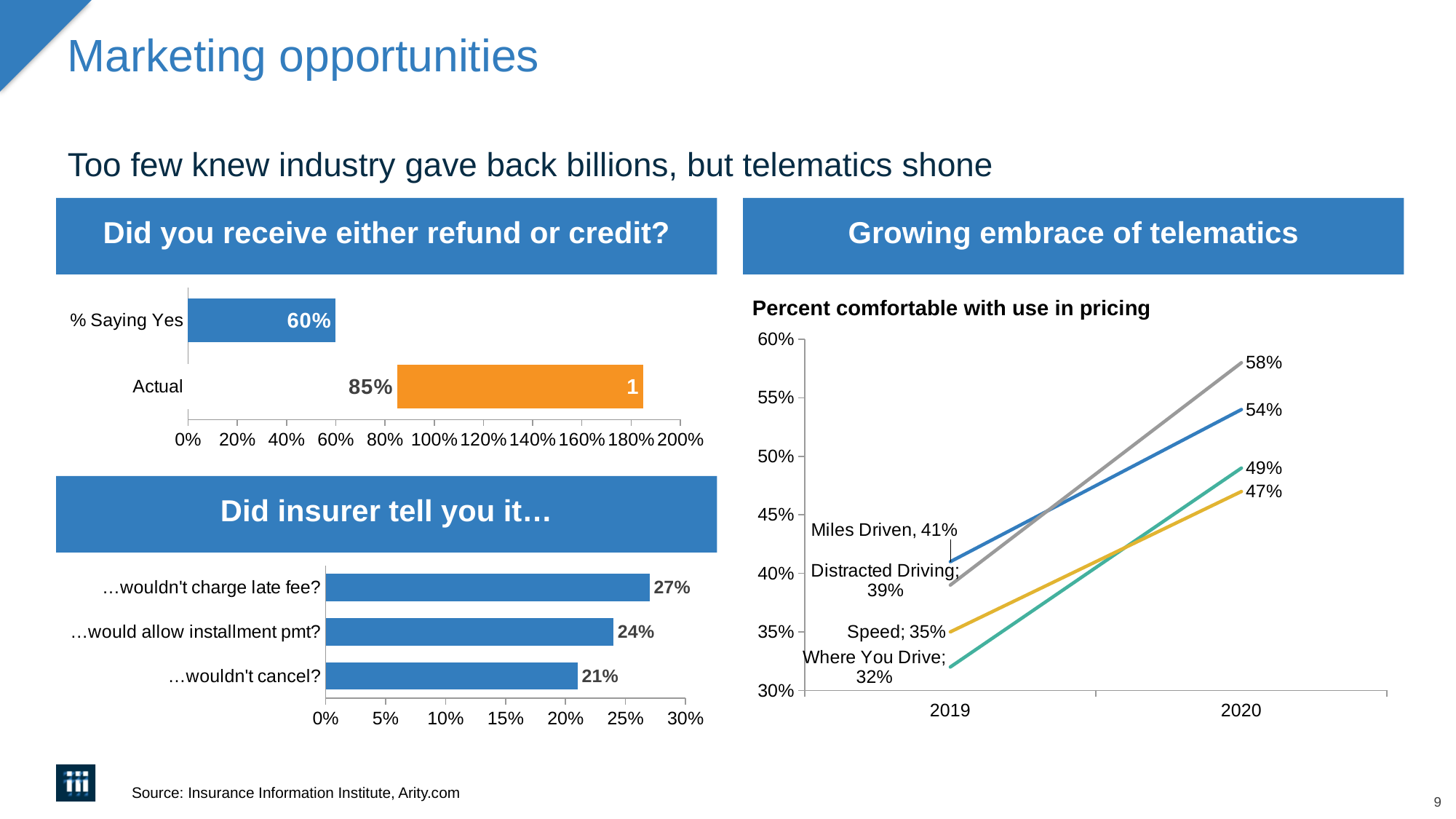
In the 'Growing embrace of telematics' chart, what is the value for Distracted Driving in 2020? 58% What kind of chart is the 'Did you receive either refund or credit?' chart? bar chart In the 'Growing embrace of telematics' chart, by how much did Miles Driven change from 2019 to 2020? 13 percentage points In the 'Did insurer tell you it…' chart, what is the value for '…wouldn't charge late fee?'? 27% In the 'Growing embrace of telematics' chart, do the values rise or fall from 2019 to 2020? rise In the 'Growing embrace of telematics' chart, which series has the highest value in 2020? Distracted Driving In the 'Did you receive either refund or credit?' chart, what is the value for '% Saying Yes'? 60% In the 'Did insurer tell you it…' chart, which category has the lowest value? …wouldn't cancel? In the 'Growing embrace of telematics' chart, which series has the lowest value in 2019? Where You Drive In the 'Did insurer tell you it…' chart, what is the difference between '…wouldn't charge late fee?' and '…would allow installment pmt?'? 3 percentage points How many categories are shown in the 'Did insurer tell you it…' chart? 3 In the 'Did insurer tell you it…' chart, what is the value for '…wouldn't cancel?'? 21%